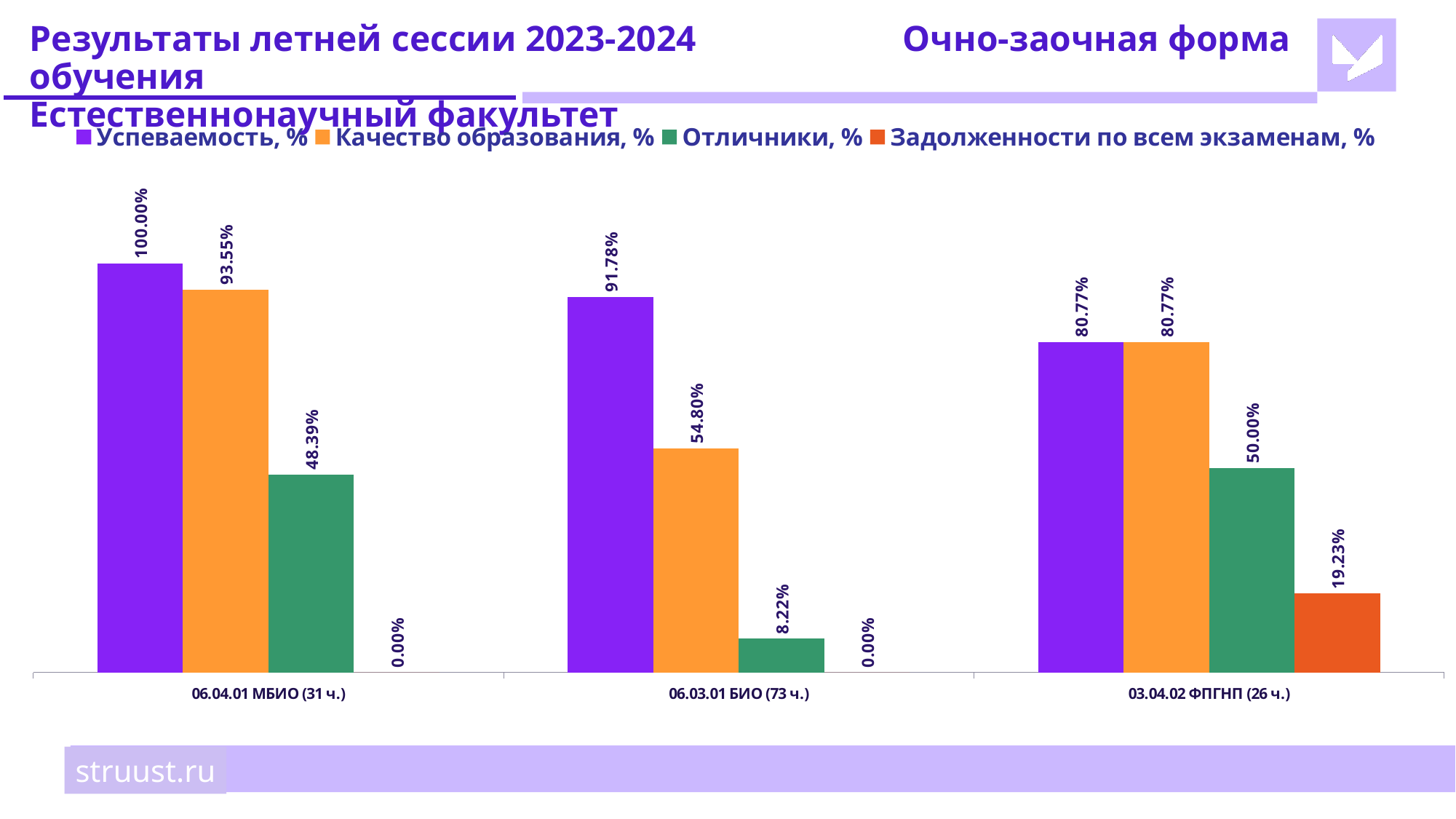
Which category has the lowest value for Отличники, %? 06.03.01 БИО (73 ч.) Which colour represents Задолженности по всем экзаменам, % in the legend? Red-orange How many series does the legend list? 4 Which is larger: Отличники, % for 06.04.01 МБИО (31 ч.) or Отличники, % for 03.04.02 ФПГНП (26 ч.)? 03.04.02 ФПГНП (26 ч.) Which category has the highest value for Успеваемость, %? 06.04.01 МБИО (31 ч.) What is the difference between Успеваемость, % and Качество образования, % for 06.03.01 БИО (73 ч.)? 36.98% How many categories are shown on the x axis? 3 What kind of chart is shown on the slide? Bar chart What is the value of Отличники, % for 03.04.02 ФПГНП (26 ч.)? 50.00% What is the value of Успеваемость, % for 06.04.01 МБИО (31 ч.)? 100.00% What is the value of Качество образования, % for 06.03.01 БИО (73 ч.)? 54.80% What is the value of Задолженности по всем экзаменам, % for 03.04.02 ФПГНП (26 ч.)? 19.23%